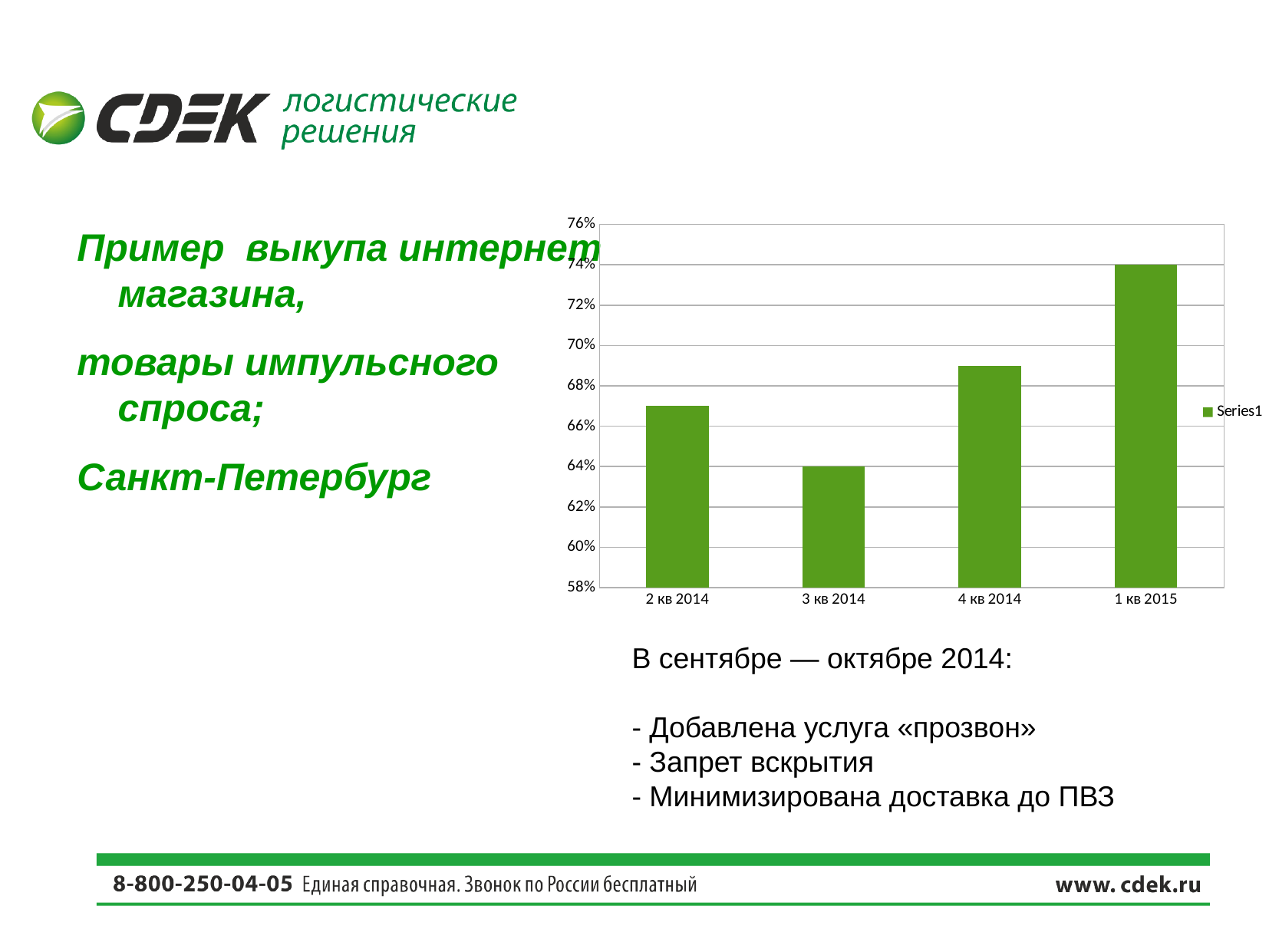
What type of chart is shown on the slide? bar chart How many series does the chart legend list? 1 What is the value for 1 кв 2015? 74% Which quarter has the highest value in the chart? 1 кв 2015 Which quarter has the lowest value in the chart? 3 кв 2014 By how many percentage points does the value for 1 кв 2015 exceed the value for 3 кв 2014? 10 percentage points Is the value for 4 кв 2014 greater or less than 70%? less Which is larger, the value for 4 кв 2014 or the value for 2 кв 2014? 4 кв 2014 What is the value for 3 кв 2014? 64% What is the name of the series shown in the chart legend? Series1 How many categories (quarters) are shown on the x axis of the chart? 4 Is the value for 2 кв 2014 greater or less than 66%? greater